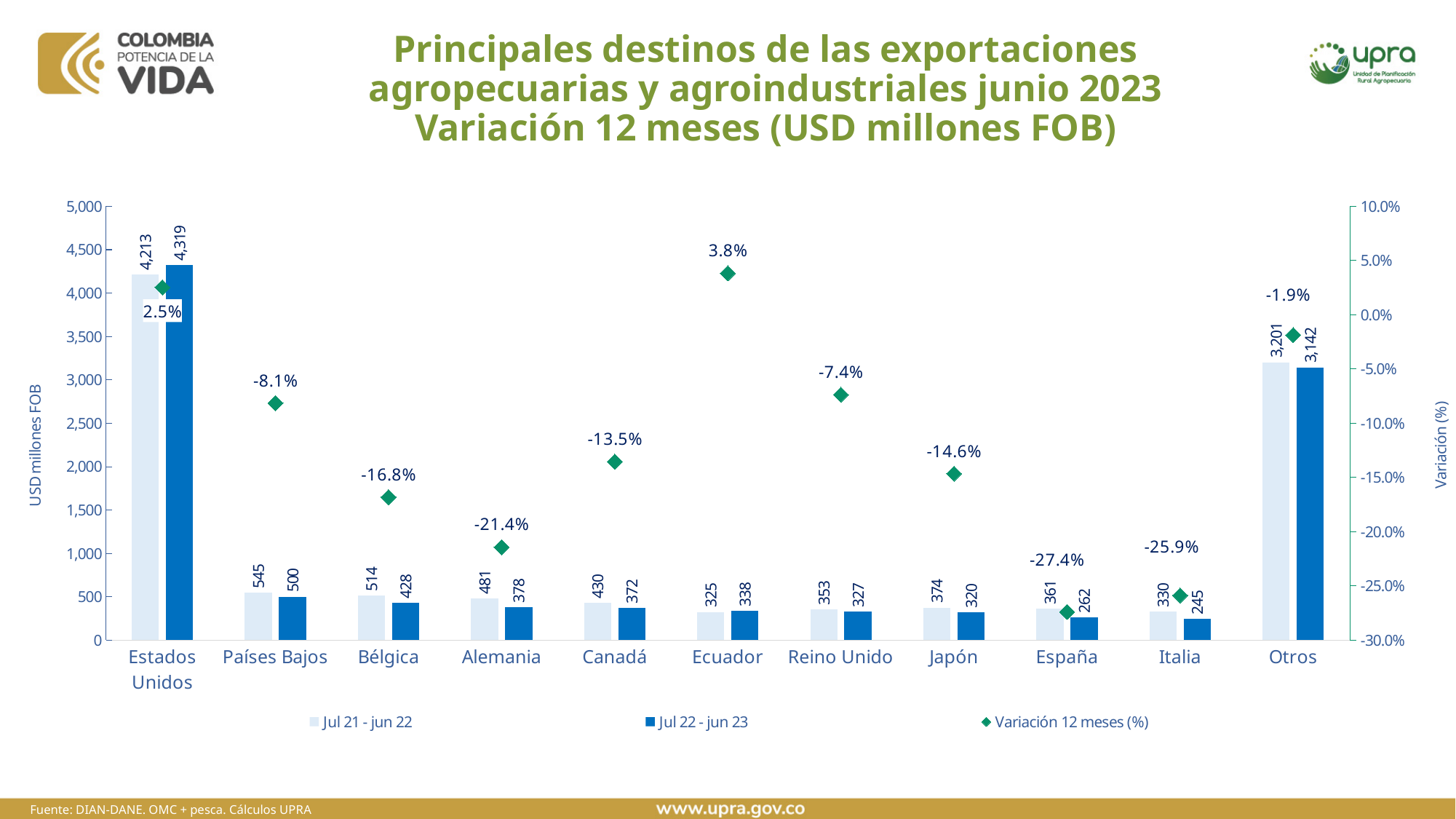
What is the Variación 12 meses (%) value for Ecuador? 3.8% What kind of chart is this? Combined bar and line (marker) chart What is the difference between the Jul 21 - jun 22 and Jul 22 - jun 23 values for Alemania? 103 Which category has the highest Jul 21 - jun 22 value? Estados Unidos What is the label of the left vertical axis? USD millones FOB What is the value for Países Bajos in the Jul 21 - jun 22 series? 545 What is the value for Estados Unidos in the Jul 22 - jun 23 series? 4,319 How many series does the legend list? 3 How many categories are shown on the x axis? 11 Which named country has the lowest Jul 22 - jun 23 value? Italia Which country has the lowest Variación 12 meses (%) value? España Which is larger for Ecuador: the Jul 21 - jun 22 value or the Jul 22 - jun 23 value? Jul 22 - jun 23